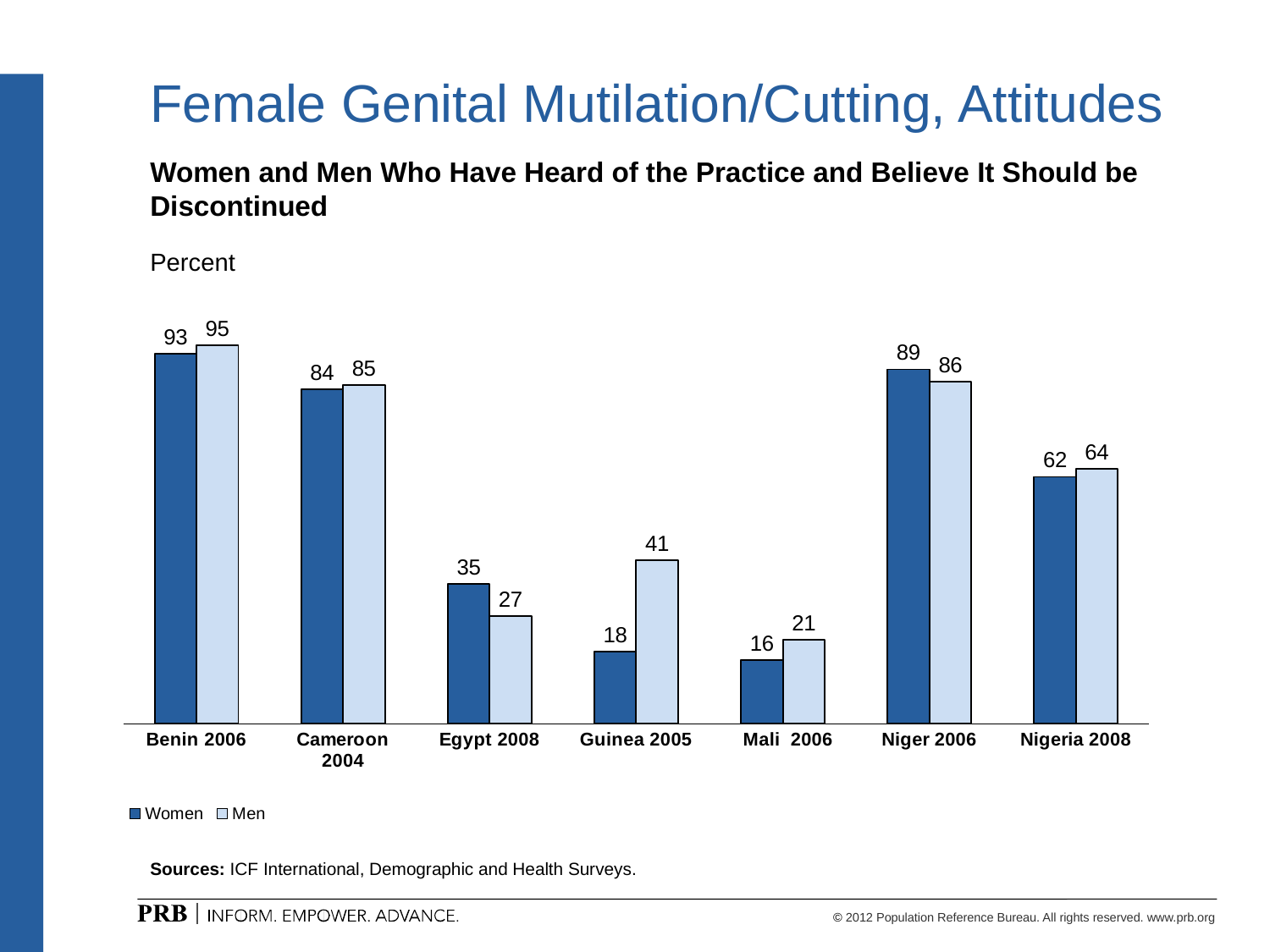
How many series does the legend list? 2 What is the value for Men in Guinea 2005? 41 How many countries are shown on the x axis? 7 What is the value for Women in Mali 2006? 16 What kind of chart is shown on the slide? Bar chart What is the difference between the Men and Women values for Guinea 2005? 23 Which is larger in Niger 2006, the value for Women or for Men? Women What is the value for Women in Benin 2006? 93 Which country has the lowest value for Women? Mali 2006 Which country has the highest value for Men? Benin 2006 What is the difference between the Women and Men values for Egypt 2008? 8 What are the two series listed in the legend? Women and Men